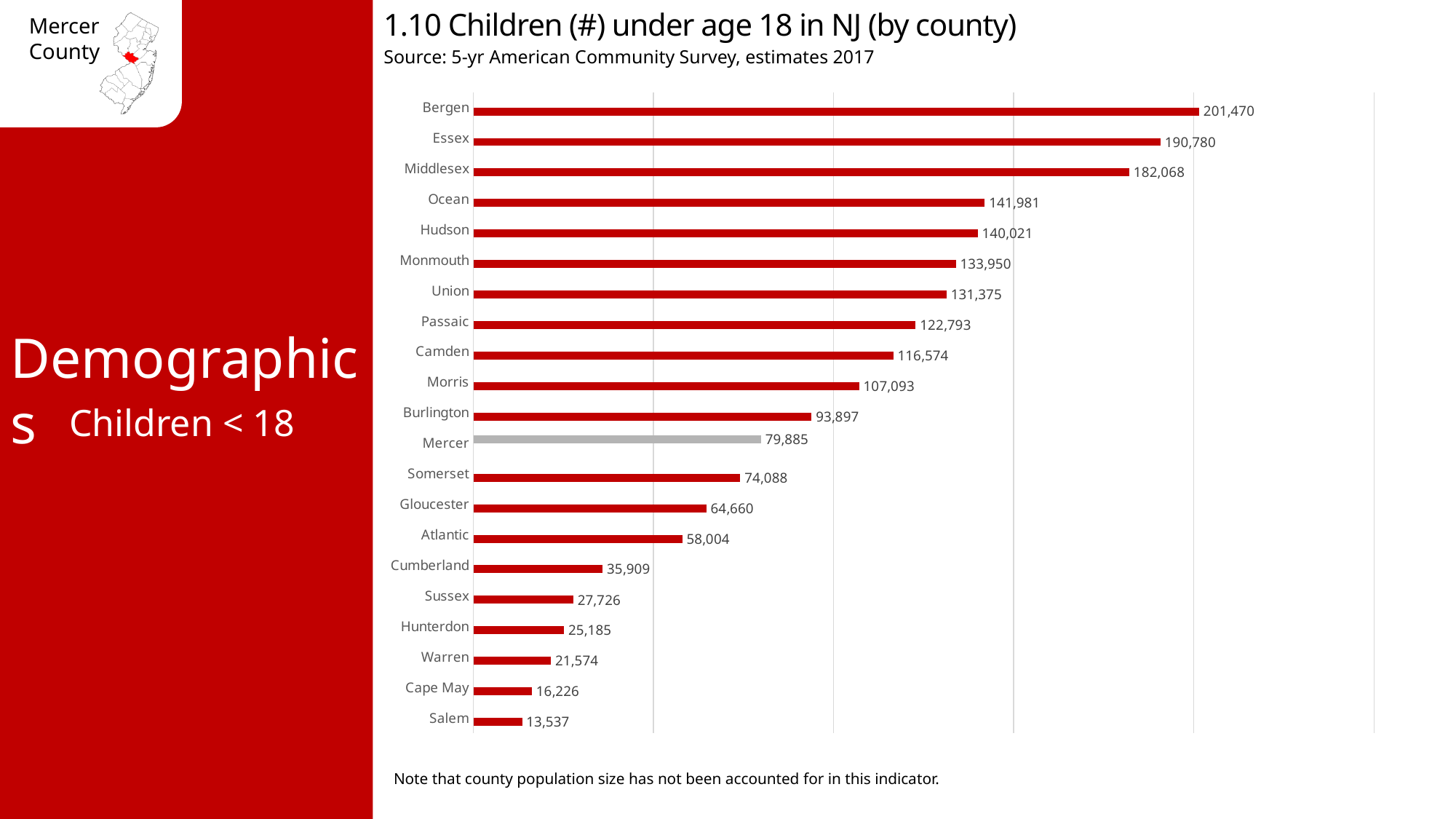
Which county has the lowest number of children under age 18? Salem How many counties are shown in the chart? 21 What is the value shown for Hudson County? 140,021 What is the value shown for Cumberland County? 35,909 What is the difference between the values for Mercer and Somerset? 5,797 What is the number of children under age 18 in Mercer County? 79,885 Which county's bar is shown in grey instead of red? Mercer Which county has the highest number of children under age 18? Bergen What is the difference between the values for Bergen and Essex? 10,690 Which has a larger value, Ocean or Monmouth? Ocean Which has a larger value, Gloucester or Atlantic? Gloucester What type of chart is shown on the slide? Bar chart